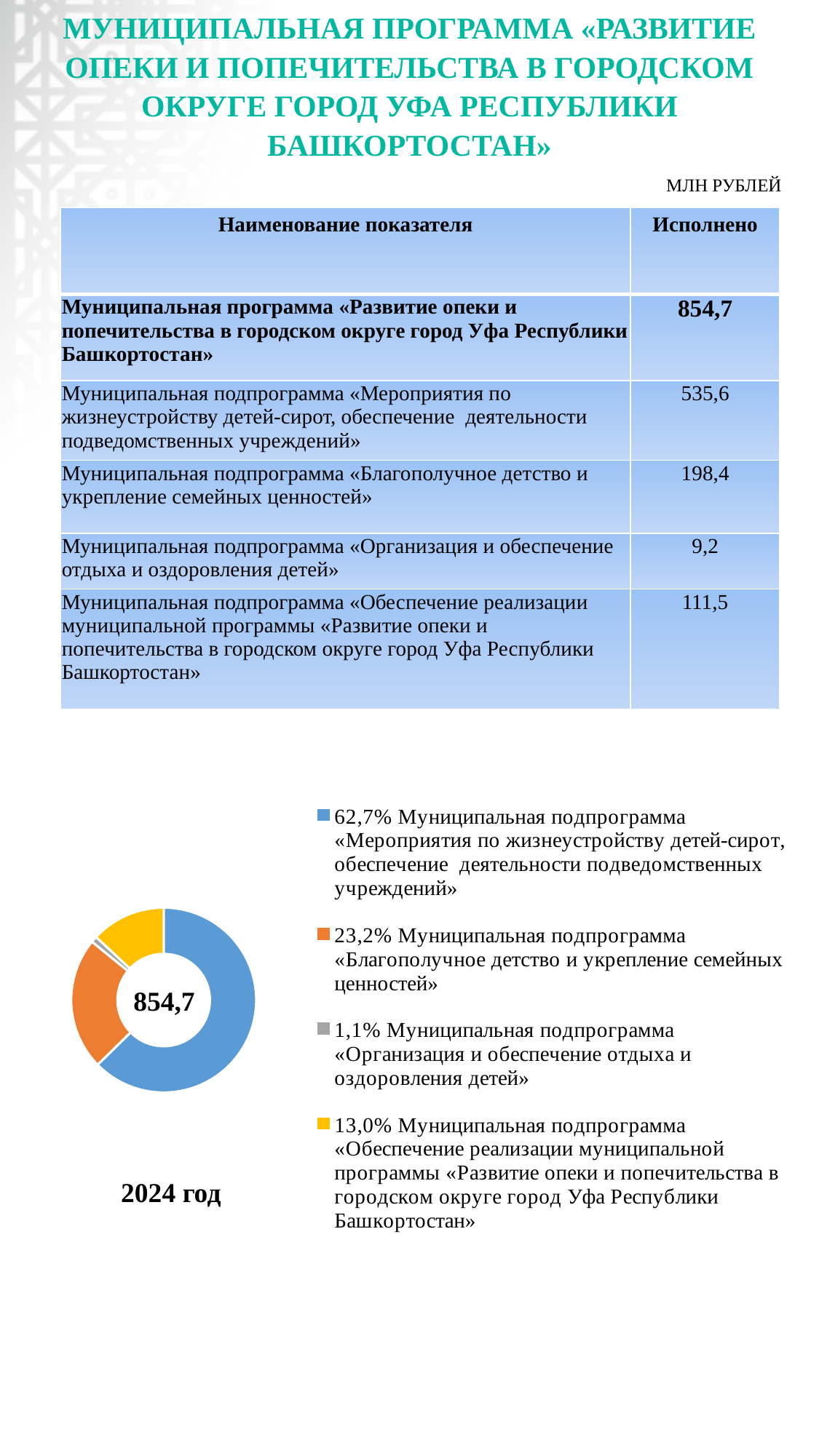
What share of the doughnut chart does the subprogramme «Мероприятия по жизнеустройству детей-сирот, обеспечение деятельности подведомственных учреждений» have? 62,7% What colour is the largest slice of the doughnut chart? Blue What share of the doughnut chart does the subprogramme «Обеспечение реализации муниципальной программы» have? 13,0% In the doughnut chart, which is larger: the share of «Благополучное детство и укрепление семейных ценностей» or the share of «Обеспечение реализации муниципальной программы»? «Благополучное детство и укрепление семейных ценностей» What share of the doughnut chart does the subprogramme «Благополучное детство и укрепление семейных ценностей» have? 23,2% Which subprogramme has the smallest slice in the doughnut chart? «Организация и обеспечение отдыха и оздоровления детей» How many entries does the legend of the doughnut chart list? 4 What value is printed in the centre of the doughnut chart? 854,7 Which subprogramme has the largest slice in the doughnut chart? «Мероприятия по жизнеустройству детей-сирот, обеспечение деятельности подведомственных учреждений» What kind of chart is shown at the bottom of the slide? Doughnut (pie) chart How many slices does the doughnut chart have? 4